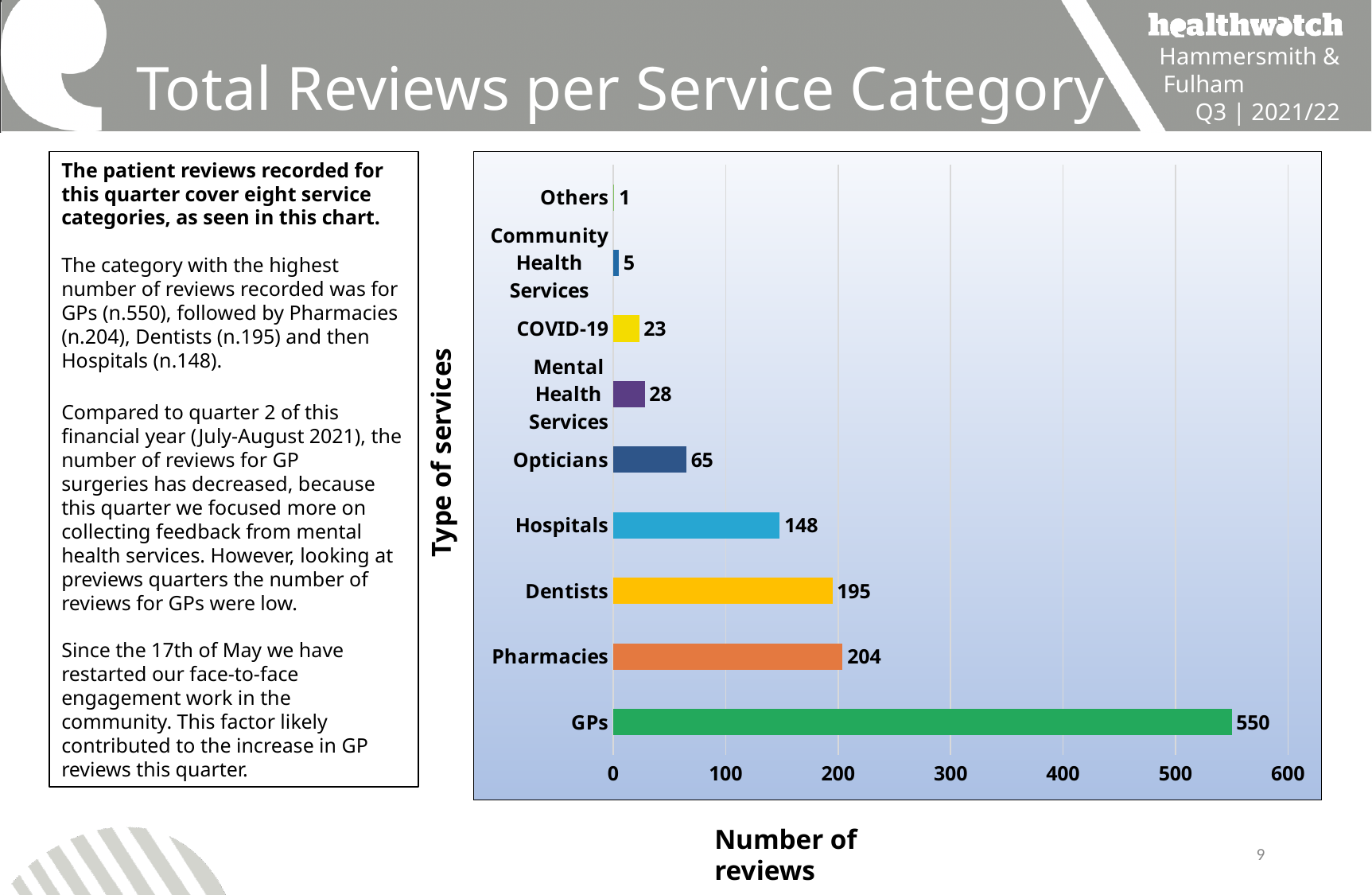
Which service category has the lowest number of reviews? Others What type of chart is shown on the slide? Bar chart How many reviews were recorded for Community Health Services? 5 What is the label of the horizontal axis of the chart? Number of reviews What is the number of reviews for Mental Health Services? 28 Which has more reviews, Dentists or Hospitals? Dentists Which has more reviews, COVID-19 or Opticians? Opticians How many service categories are shown in the chart? 9 What is the difference in number of reviews between GPs and Pharmacies? 346 What is the difference in number of reviews between Hospitals and Opticians? 83 How many reviews were recorded for Pharmacies? 204 Which service category has the highest number of reviews? GPs